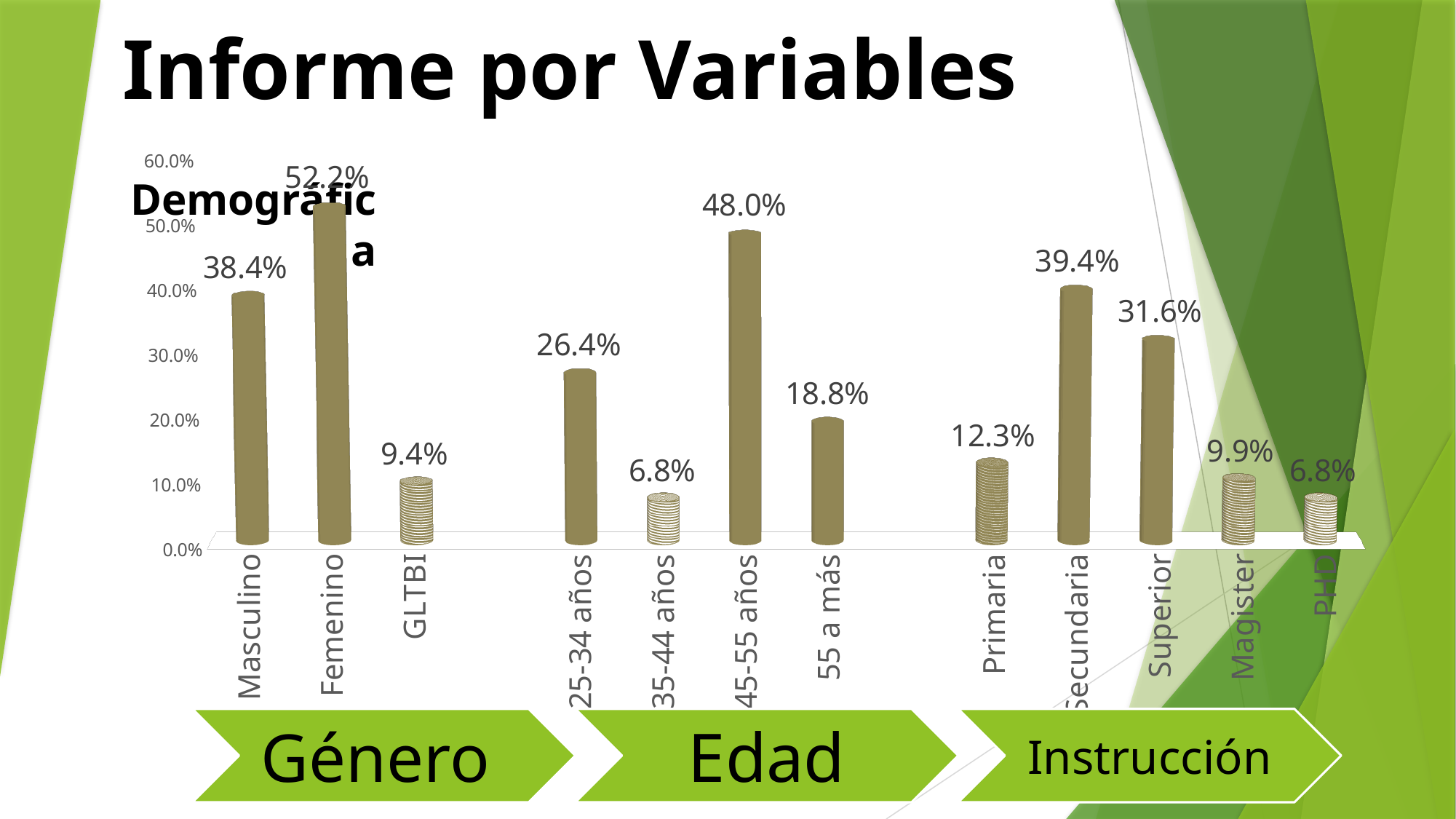
Is the value for Secundaria greater or less than 30.0%? greater What is the value for Primaria? 12.3% What is the difference between the values for Femenino and Masculino? 13.8% Which is larger, the value for 25-34 años or the value for 55 a más? 25-34 años What is the difference between the values for Secundaria and Superior? 7.8% What is the value for 45-55 años? 48.0% What kind of chart is shown on the slide? bar chart What is the value for Femenino? 52.2% What are the three group labels shown below the chart? Género, Edad, Instrucción What is the value for Magister? 9.9% How many categories are shown on the x axis? 12 Which category has the highest value? Femenino